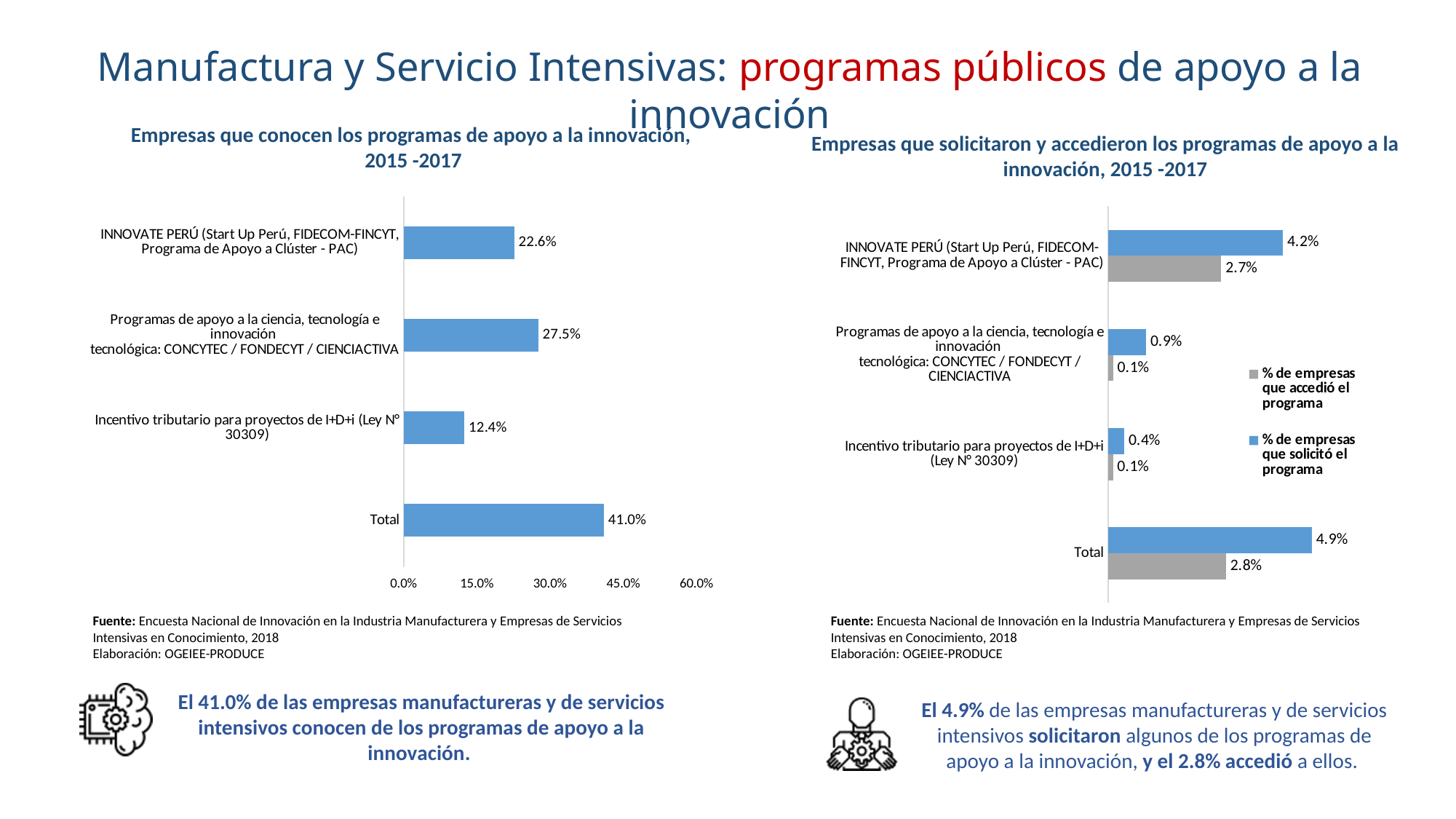
In the right chart (Empresas que solicitaron y accedieron los programas de apoyo a la innovación, 2015-2017), how many series does the legend list? 2 In the right chart (Empresas que solicitaron y accedieron los programas de apoyo a la innovación, 2015-2017), what is the value of '% de empresas que solicitó el programa' for INNOVATE PERÚ? 4.2% In the left chart (Empresas que conocen los programas de apoyo a la innovación, 2015-2017), what is the value for Incentivo tributario para proyectos de I+D+i (Ley N° 30309)? 12.4% In the right chart (Empresas que solicitaron y accedieron los programas de apoyo a la innovación, 2015-2017), which is larger for CONCYTEC / FONDECYT / CIENCIACTIVA: the '% de empresas que solicitó el programa' or the '% de empresas que accedió el programa'? % de empresas que solicitó el programa In the left chart (Empresas que conocen los programas de apoyo a la innovación, 2015-2017), how many categories are shown? 4 In the left chart (Empresas que conocen los programas de apoyo a la innovación, 2015-2017), what type of chart is shown? Bar chart In the left chart (Empresas que conocen los programas de apoyo a la innovación, 2015-2017), what is the value for Total? 41.0% In the right chart (Empresas que solicitaron y accedieron los programas de apoyo a la innovación, 2015-2017), what is the difference between the '% de empresas que solicitó el programa' and '% de empresas que accedió el programa' values for Total? 2.1% In the right chart (Empresas que solicitaron y accedieron los programas de apoyo a la innovación, 2015-2017), which colour represents '% de empresas que accedió el programa'? Gray In the right chart (Empresas que solicitaron y accedieron los programas de apoyo a la innovación, 2015-2017), what is the value of '% de empresas que accedió el programa' for Total? 2.8% In the left chart (Empresas que conocen los programas de apoyo a la innovación, 2015-2017), which of the three individual programs (excluding Total) has the highest value? Programas de apoyo a la ciencia, tecnología e innovación tecnológica: CONCYTEC / FONDECYT / CIENCIACTIVA In the left chart (Empresas que conocen los programas de apoyo a la innovación, 2015-2017), what is the difference between the values for CONCYTEC / FONDECYT / CIENCIACTIVA and INNOVATE PERÚ? 4.9%